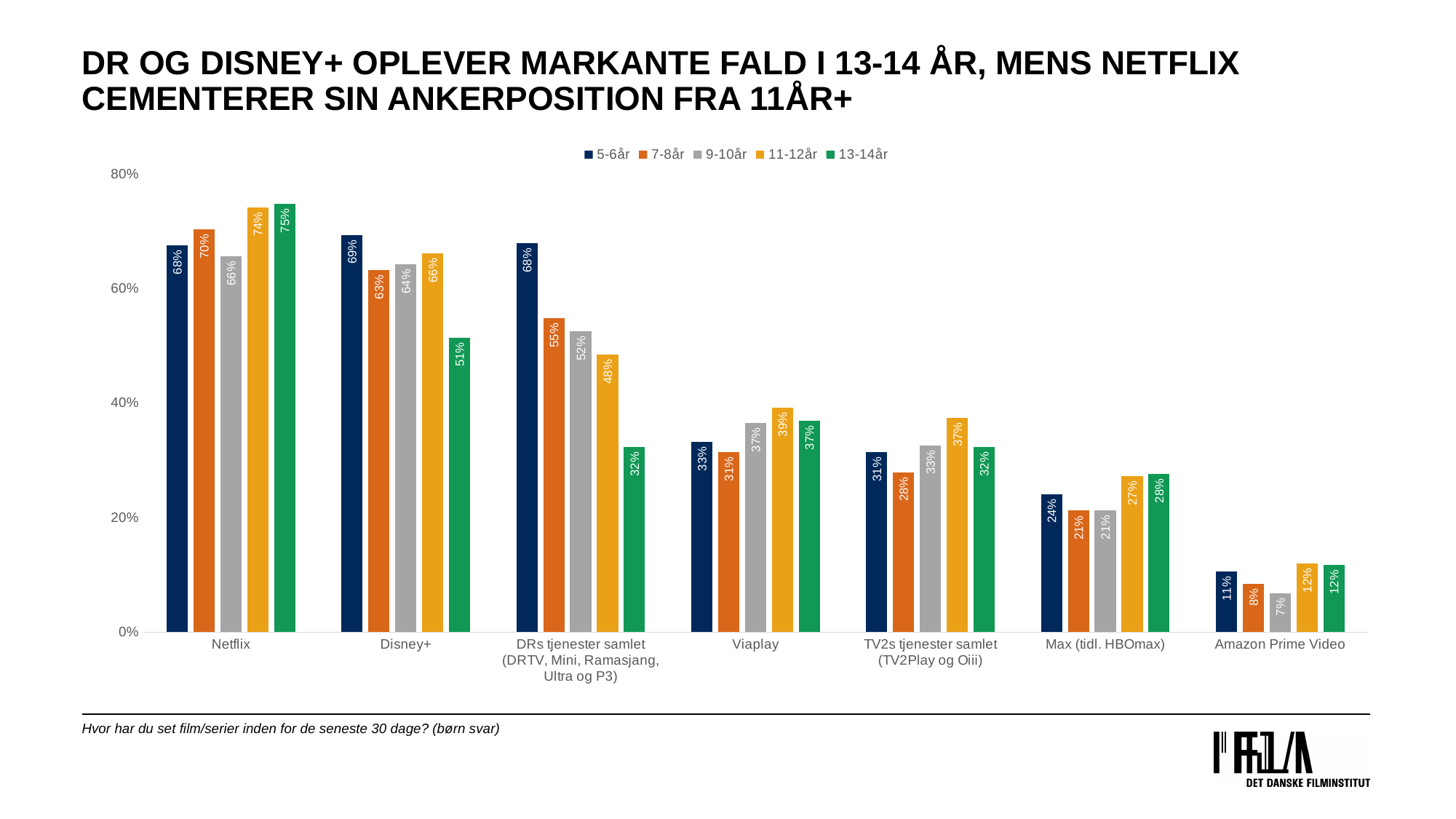
What is the difference between the 5-6år and 13-14år values for DRs tjenester samlet? 36% Which category has the lowest value in the 7-8år series? Amazon Prime Video What is the value for DRs tjenester samlet in the 5-6år series? 68% Which is larger for Viaplay: the 11-12år value or the 5-6år value? 11-12år Which series is shown in green in the legend? 13-14år What is the value for Disney+ in the 13-14år series? 51% Which category has the highest value in the 13-14år series? Netflix What kind of chart is shown on the slide? Bar chart How many categories are shown on the x axis? 7 How many series does the legend list? 5 What is the value for Netflix in the 13-14år series? 75% What is the value for Amazon Prime Video in the 9-10år series? 7%